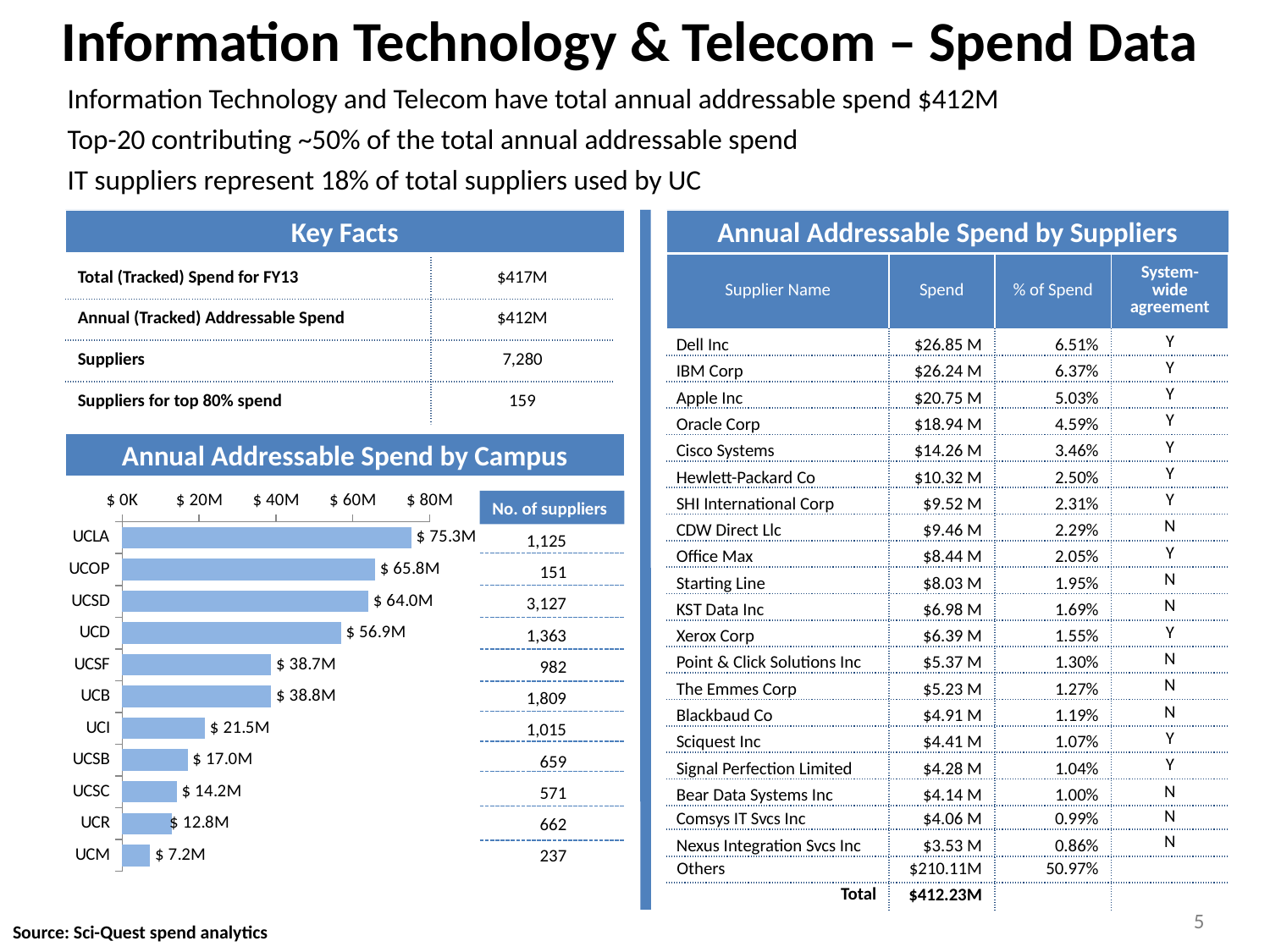
How many campuses are shown in the Annual Addressable Spend by Campus chart? 11 In the Annual Addressable Spend by Campus chart, what is the value for UCM? $ 7.2M In the Annual Addressable Spend by Campus chart, which campus has the highest spend? UCLA In the Annual Addressable Spend by Campus chart, what is the value for UCSB? $ 17.0M In the Annual Addressable Spend by Campus chart, what is the value for UCSD? $ 64.0M What kind of chart is the Annual Addressable Spend by Campus chart? bar chart In the Annual Addressable Spend by Campus chart, which campus has the lowest spend? UCM In the Annual Addressable Spend by Campus chart, what is the difference between the values for UCLA and UCOP? $ 9.5M In the Annual Addressable Spend by Campus chart, what is the value for UCLA? $ 75.3M In the Annual Addressable Spend by Campus chart, what is the difference between the values for UCI and UCR? $ 8.7M In the Annual Addressable Spend by Campus chart, is the value for UCSC greater or less than $ 20M? less In the Annual Addressable Spend by Campus chart, which is larger, the value for UCD or the value for UCI? UCD